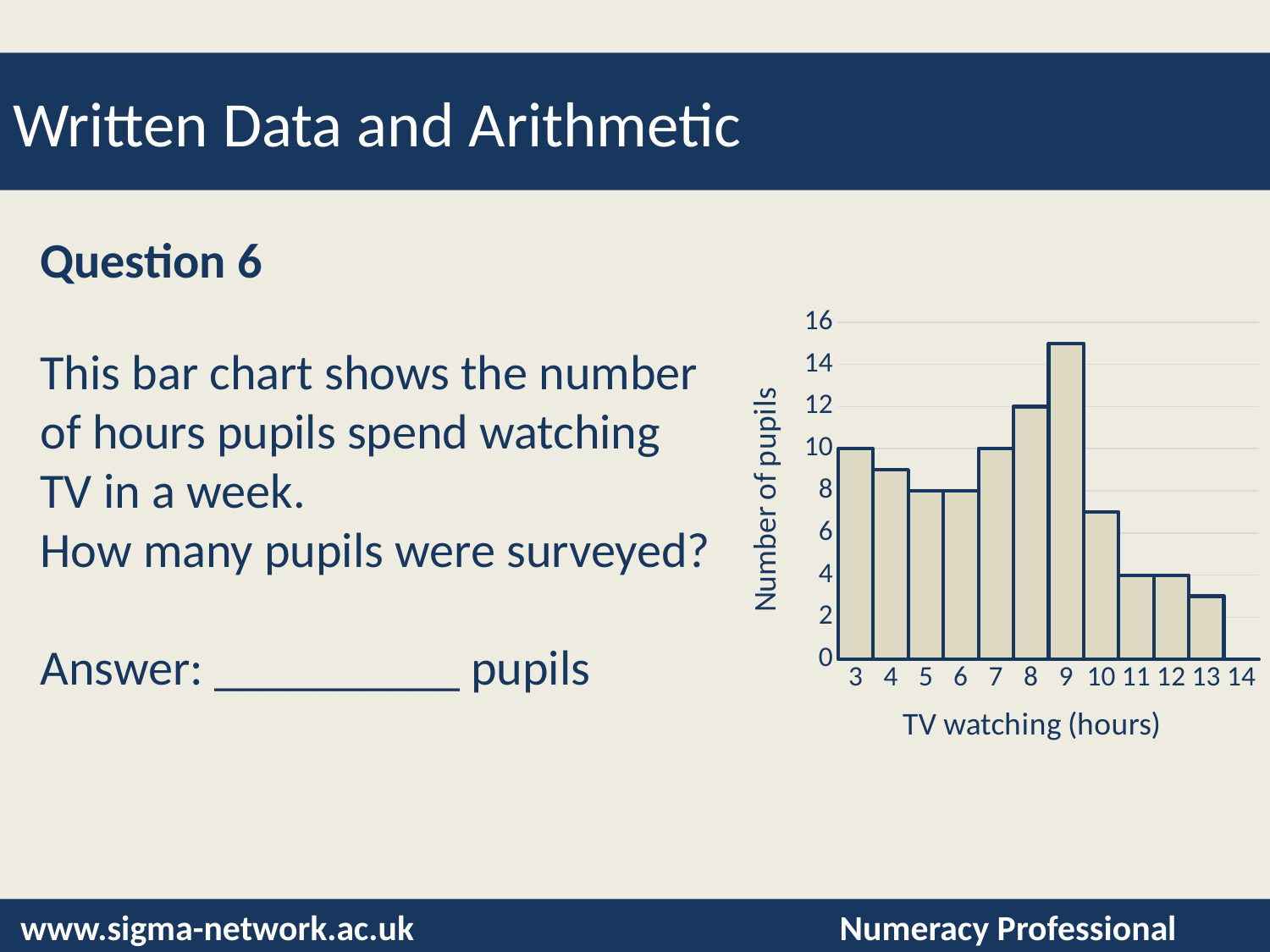
Is the number of pupils watching 10 hours of TV greater or less than 8? less Is the number of pupils watching 9 hours of TV greater or less than 14? greater What kind of chart is shown on the slide? bar chart How many pupils watch 11 hours of TV? 4 Which has more pupils: 7 hours of TV or 10 hours of TV? 7 hours What is the label on the vertical axis of the chart? Number of pupils How many pupils watch 8 hours of TV? 12 Which number of TV watching hours has the highest number of pupils? 9 Which number of TV watching hours has the lowest number of pupils? 14 How many pupils watch 3 hours of TV? 10 How many bars are plotted in the chart? 11 What is the difference between the number of pupils watching 8 hours and the number watching 3 hours of TV? 2